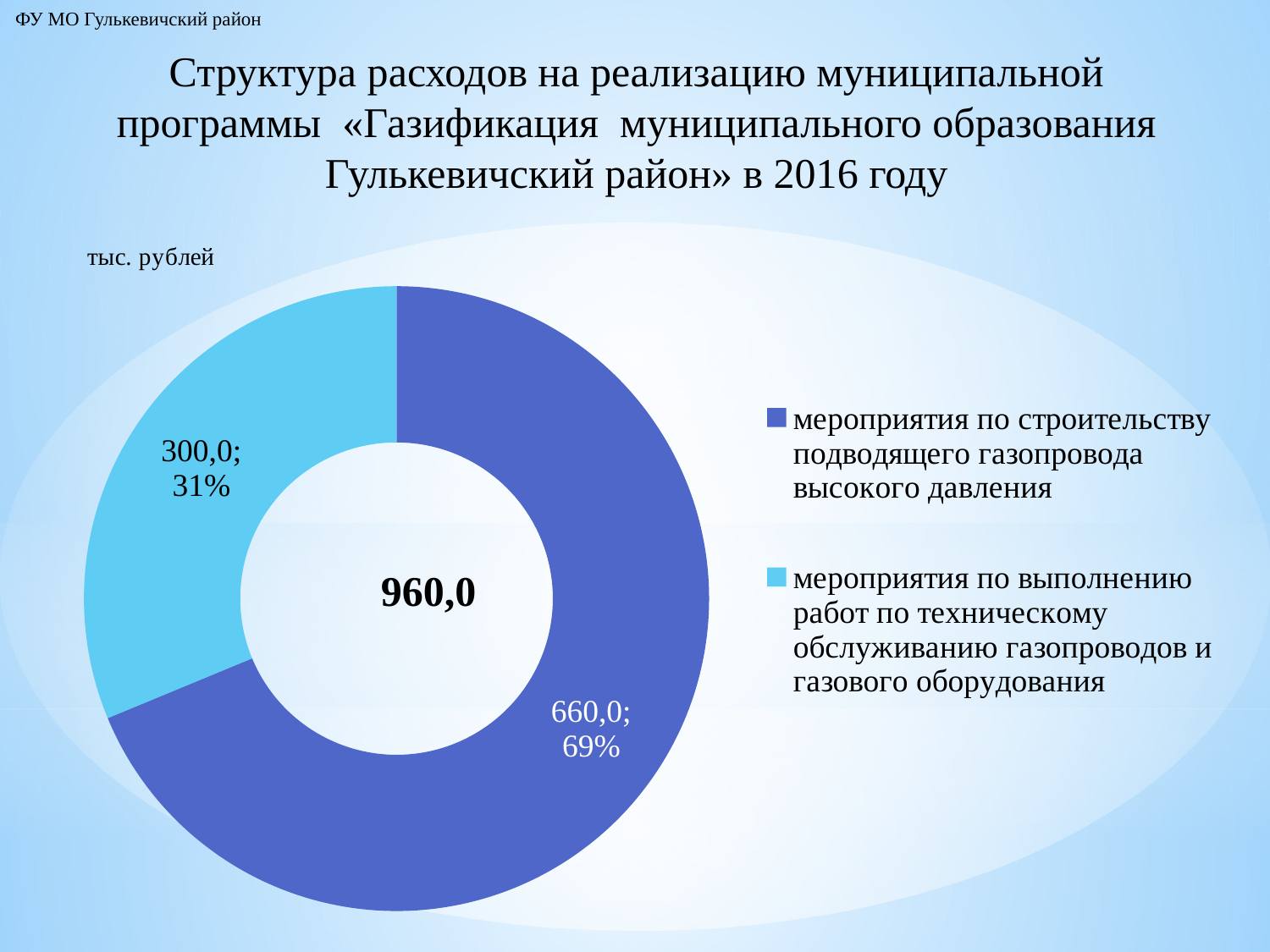
Which category has the largest value? мероприятия по строительству подводящего газопровода высокого давления What share of the chart does 'мероприятия по строительству подводящего газопровода высокого давления' represent? 69% Which category has the smallest value? мероприятия по выполнению работ по техническому обслуживанию газопроводов и газового оборудования What is the value for 'мероприятия по строительству подводящего газопровода высокого давления'? 660,0 How many categories does the chart show? 2 What share of the chart does 'мероприятия по выполнению работ по техническому обслуживанию газопроводов и газового оборудования' represent? 31% What unit of measurement is indicated for the chart values? тыс. рублей What total value is shown in the centre of the chart? 960,0 Which is larger: the value for construction of the high-pressure supply gas pipeline or the value for maintenance of gas pipelines and equipment? construction of the high-pressure supply gas pipeline (660,0) What kind of chart is shown on the slide? doughnut (pie) chart What is the difference between the values for construction of the high-pressure supply gas pipeline and maintenance of gas pipelines and equipment? 360,0 What is the value for 'мероприятия по выполнению работ по техническому обслуживанию газопроводов и газового оборудования'? 300,0